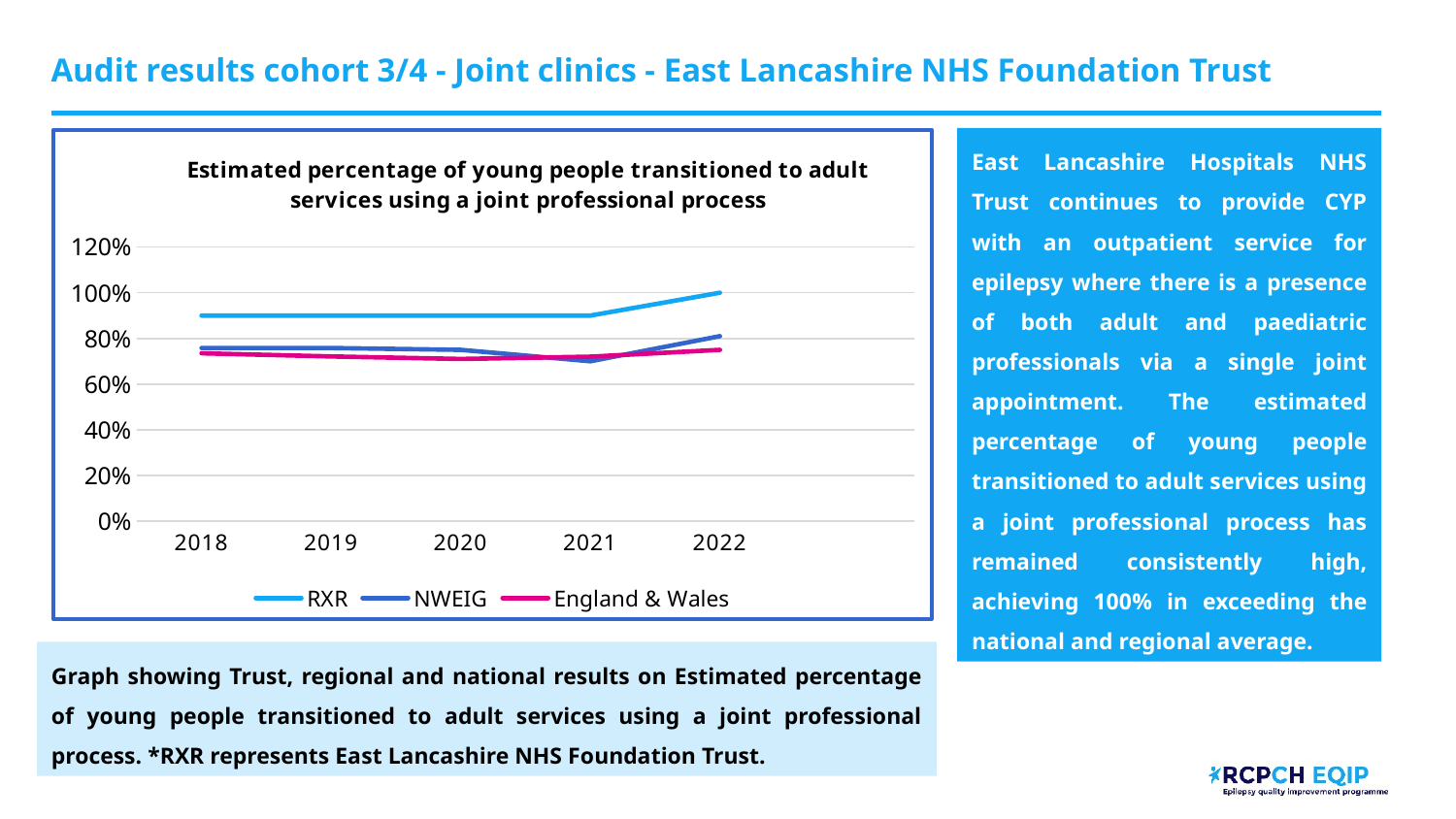
What kind of chart is shown on the slide? Line chart Does the RXR line rise or fall between 2021 and 2022? Rise How many years are shown on the x axis of the chart? 5 How many series does the chart legend list? 3 In which year is the RXR value highest? 2022 Which is larger in 2022, the value for RXR or the value for England & Wales? RXR Is the value for NWEIG in 2021 greater or less than 80%? less What is the value for RXR in 2022? 100% Is the value for RXR in 2018 greater or less than 80%? greater Which is larger in 2018, the value for RXR or the value for NWEIG? RXR Which series is drawn in pink in the chart? England & Wales Is the value for England & Wales in 2022 greater or less than 80%? less